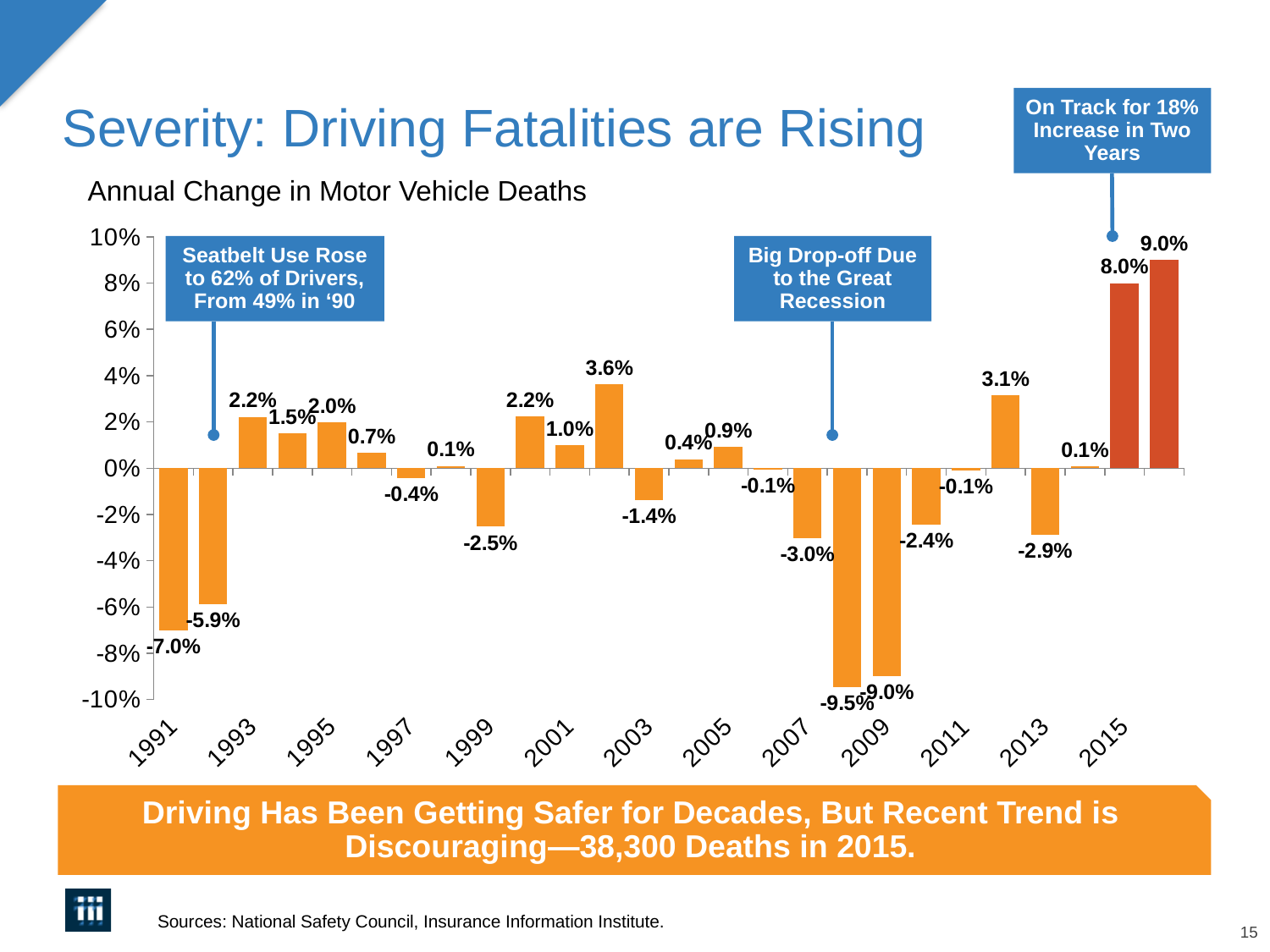
Which is larger, the value for 2003 or the value for 2013? 2003 What is the value for 1991? -7.0% Is the value for 2015 greater or less than 6%? greater What is the subtitle of the chart? Annual Change in Motor Vehicle Deaths How many bars are plotted on the chart? 26 What kind of chart is shown on the slide? bar chart What is the value for 2009? -9.0% What is the value for 2015? 8.0% What is the value for 2013? -2.9% What is the lowest value shown on the chart? -9.5% What is the highest value shown on the chart? 9.0% What is the difference between the values for 2007 and 2009? 6.0 percentage points